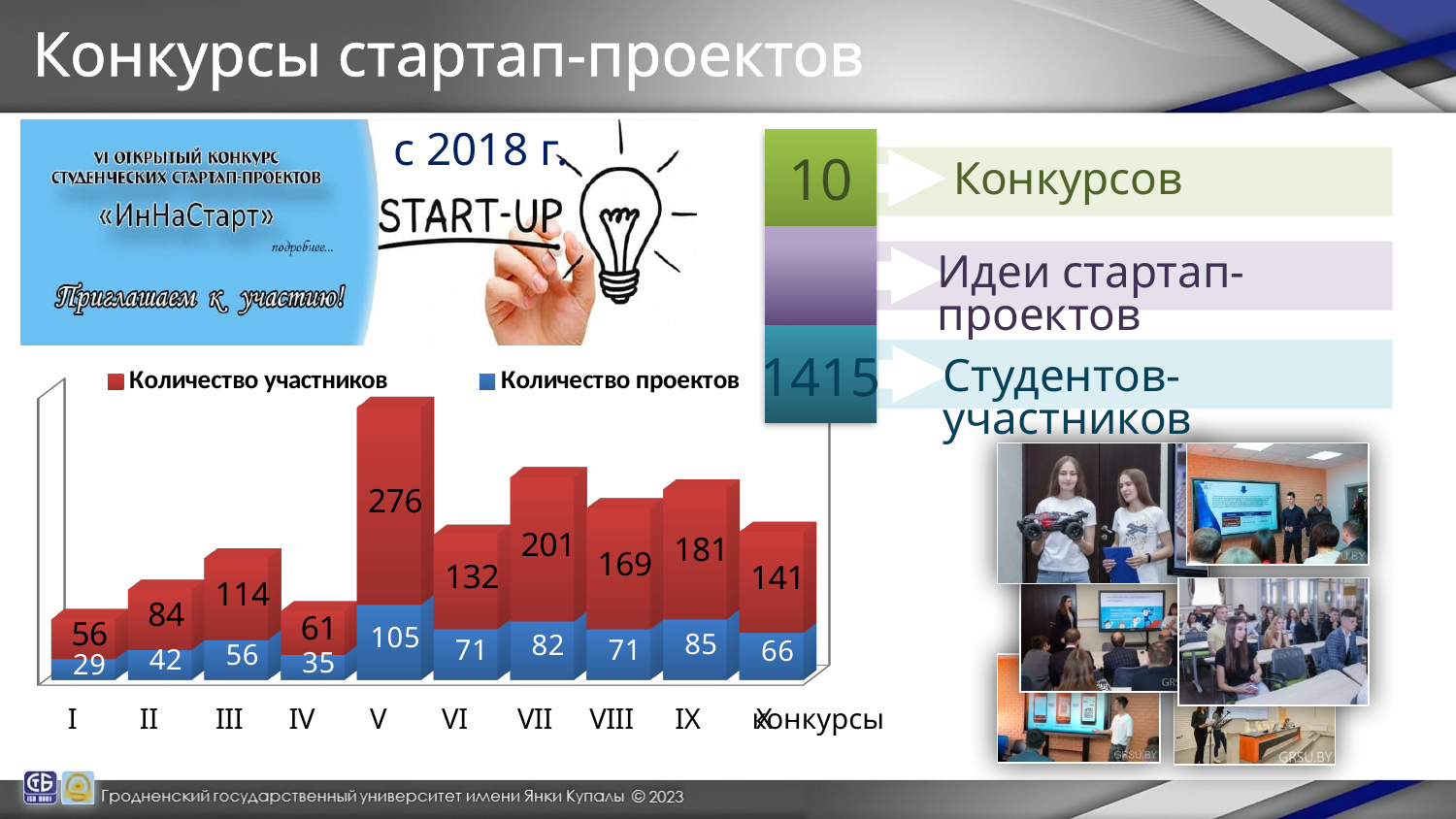
What type of chart is shown on the slide? stacked bar chart What is the value of Количество участников for competition V? 276 What is the total of the stacked bar for competition V? 381 What is the total of the stacked bar for competition I? 85 Which competition has the highest Количество участников? V What is the value of Количество участников for competition VII? 201 Which is larger: Количество проектов for competition VI or for competition IX? IX Which series is shown in red in the chart legend? Количество участников How many series does the chart legend list? 2 What is the difference between Количество участников for competition IX and competition VIII? 12 What is the value of Количество проектов for competition III? 56 Which competition has the lowest Количество проектов? I